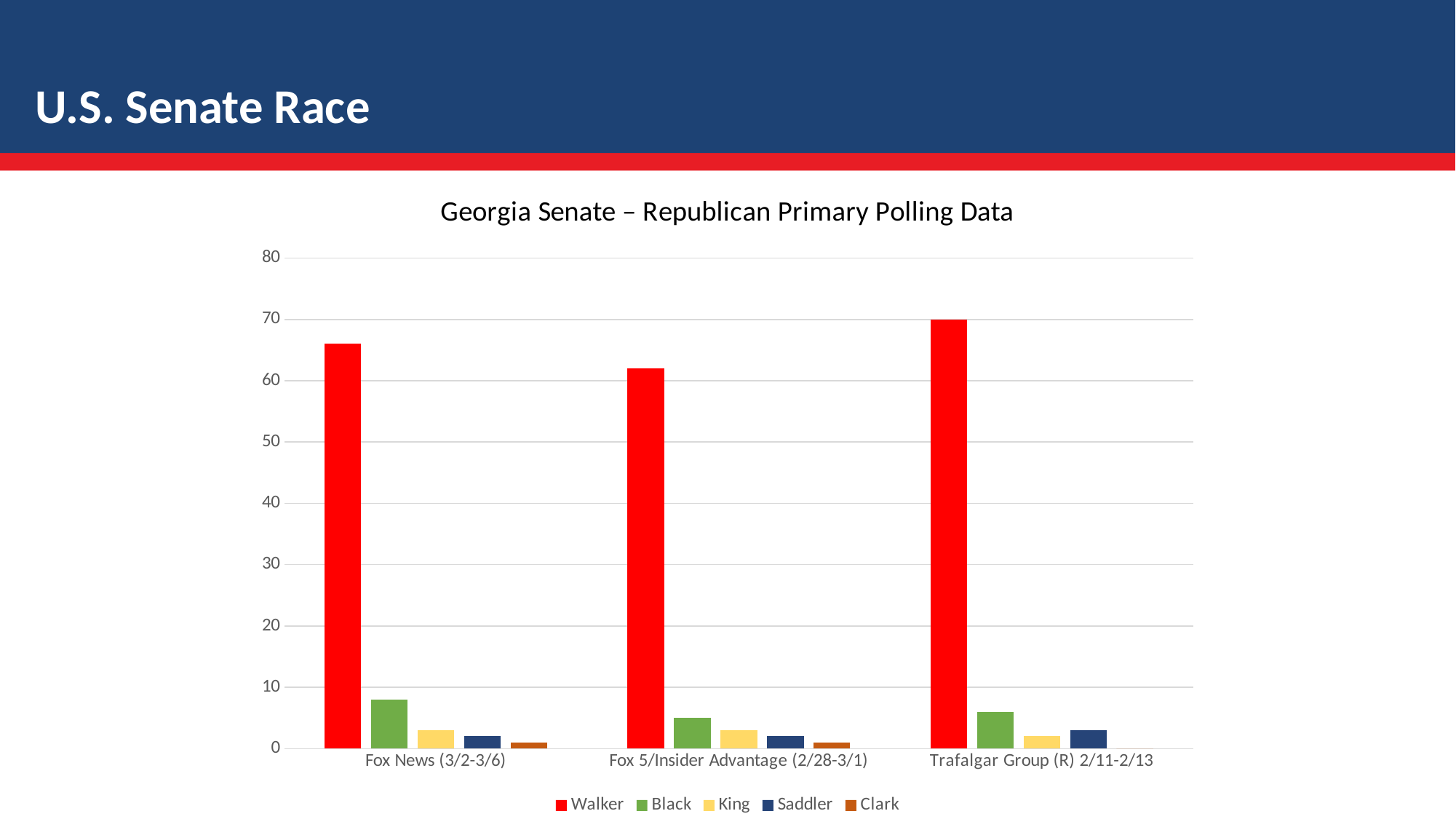
How many polls (categories) are shown on the x axis? 3 Is the value for Black in the Fox News (3/2-3/6) poll greater or less than 10? less Which candidate has the highest value in the Fox News (3/2-3/6) poll? Walker What is the title of the chart? Georgia Senate – Republican Primary Polling Data What colour represents Walker in the legend? red How many series does the legend list? 5 What kind of chart is shown on the slide? bar chart Is the value for Walker in the Fox News (3/2-3/6) poll greater or less than 60? greater Which is larger: Black's value in the Fox News (3/2-3/6) poll or Black's value in the Fox 5/Insider Advantage (2/28-3/1) poll? Fox News (3/2-3/6) Is the value for Walker in the Fox 5/Insider Advantage (2/28-3/1) poll greater or less than 70? less Which candidate has the lowest value in the Fox 5/Insider Advantage (2/28-3/1) poll? Clark Which is larger: Walker's value in the Trafalgar Group (R) 2/11-2/13 poll or Walker's value in the Fox 5/Insider Advantage (2/28-3/1) poll? Trafalgar Group (R) 2/11-2/13